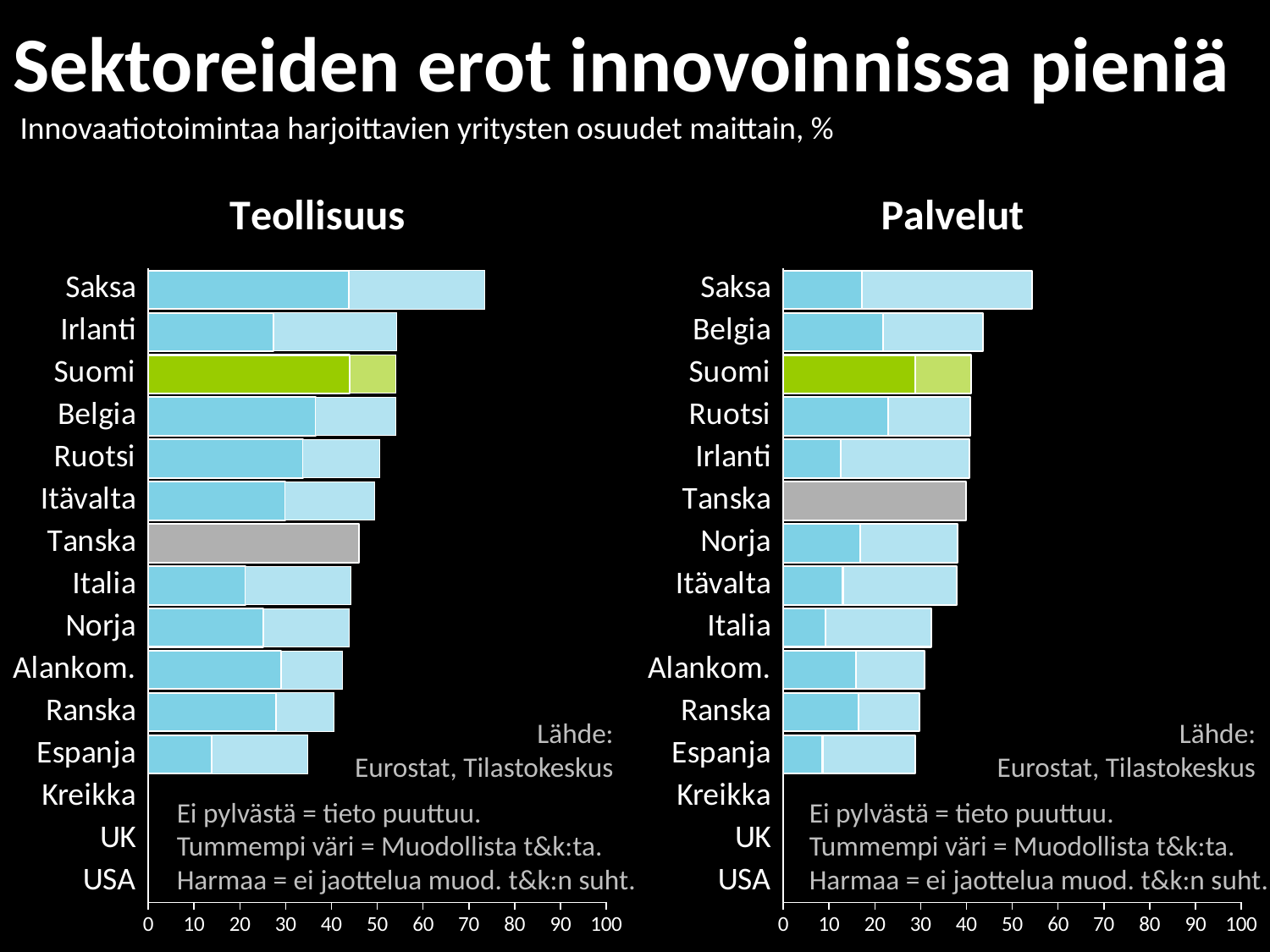
In the Palvelut chart, which country has the highest value? Saksa In the Teollisuus chart, which country with a bar has the lowest value? Espanja In the Teollisuus chart, is the total value for Saksa greater or less than 70? greater What kind of chart is the Teollisuus chart? bar chart In the Teollisuus chart, which country has the highest value? Saksa In the Palvelut chart, is the total value for Saksa greater or less than 50? greater In the Teollisuus chart, which is larger, the value for Saksa or the value for Ranska? Saksa How many countries are listed on the vertical axis of the Palvelut chart? 15 In the Teollisuus chart, is the total value for Espanja greater or less than 40? less In the Teollisuus chart, how many countries have a bar plotted? 12 In the Palvelut chart, which country's bar is shown in grey? Tanska